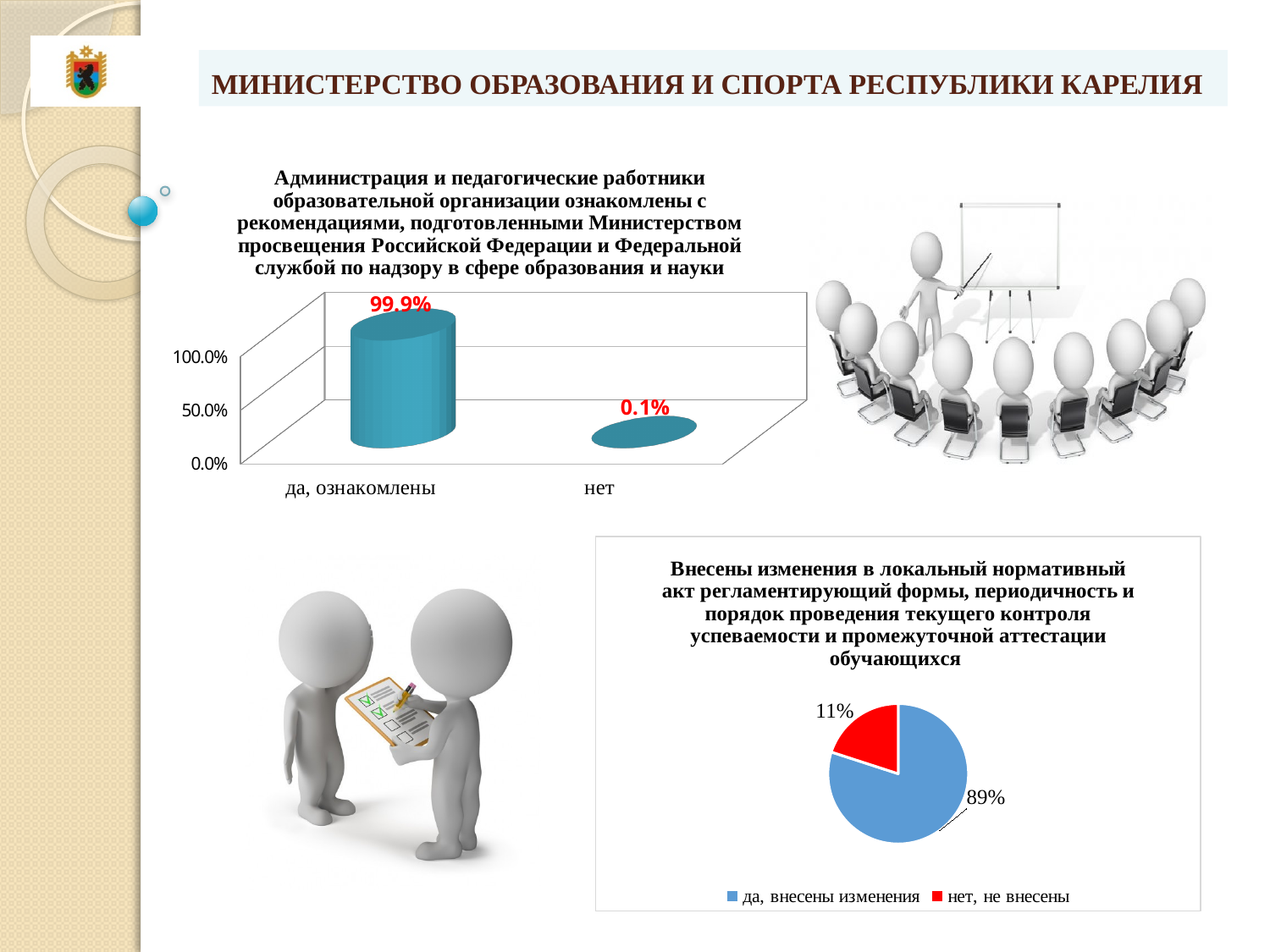
In the bar chart at the top left of the slide, is the value for "да, ознакомлены" greater or less than 50.0%? greater In the pie chart at the bottom right of the slide, which slice is larger: "да, внесены изменения" or "нет, не внесены"? да, внесены изменения In the bar chart at the top left of the slide, how many categories are shown on the x axis? 2 In the bar chart at the top left of the slide, which category has the lowest value? нет In the pie chart at the bottom right of the slide, what share is labelled for "да, внесены изменения"? 89% In the bar chart at the top left of the slide, which category has the highest value? да, ознакомлены In the pie chart at the bottom right of the slide, how many entries does the legend list? 2 In the bar chart at the top left of the slide, what is the value for "нет"? 0.1% What kind of chart is shown at the top left of the slide? bar chart In the bar chart at the top left of the slide, what is the difference between the values for "да, ознакомлены" and "нет"? 99.8% In the pie chart at the bottom right of the slide, what share is labelled for "нет, не внесены"? 11% In the bar chart at the top left of the slide, what is the value for "да, ознакомлены"? 99.9%